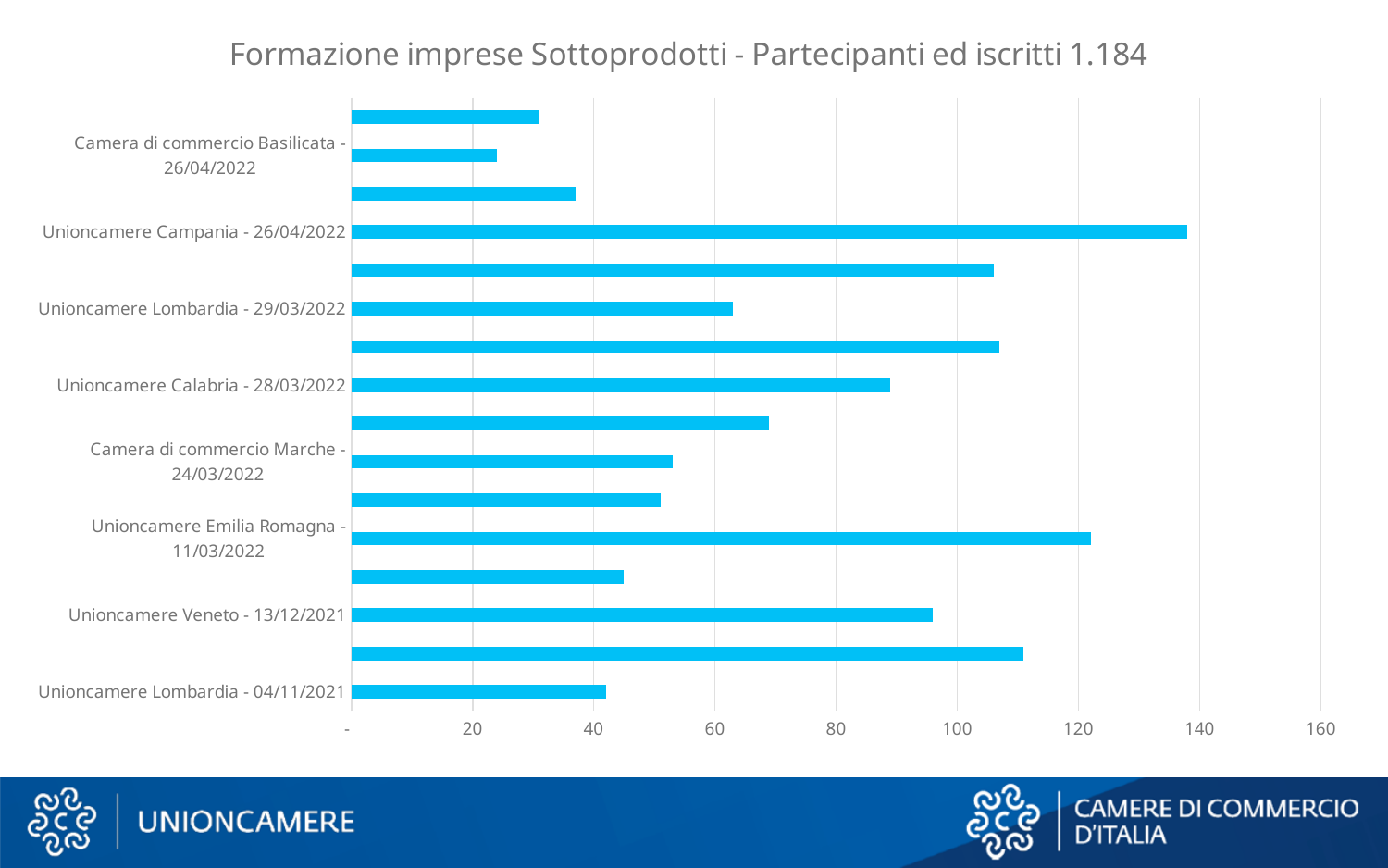
What kind of chart is shown on the slide? bar chart Which labelled category has the longest bar? Unioncamere Campania - 26/04/2022 What is the highest value shown on the horizontal axis? 160 Is the value for Unioncamere Calabria - 28/03/2022 greater or less than 80? greater What is the title of the chart? Formazione imprese Sottoprodotti - Partecipanti ed iscritti 1.184 Which is larger, the value for Unioncamere Campania - 26/04/2022 or for Unioncamere Veneto - 13/12/2021? Unioncamere Campania - 26/04/2022 Which is larger, the value for Unioncamere Calabria - 28/03/2022 or for Camera di commercio Marche - 24/03/2022? Unioncamere Calabria - 28/03/2022 Is the value for Unioncamere Campania - 26/04/2022 greater or less than 120? greater Which labelled category has the shortest bar? Camera di commercio Basilicata - 26/04/2022 Is the value for Unioncamere Lombardia - 04/11/2021 greater or less than 60? less